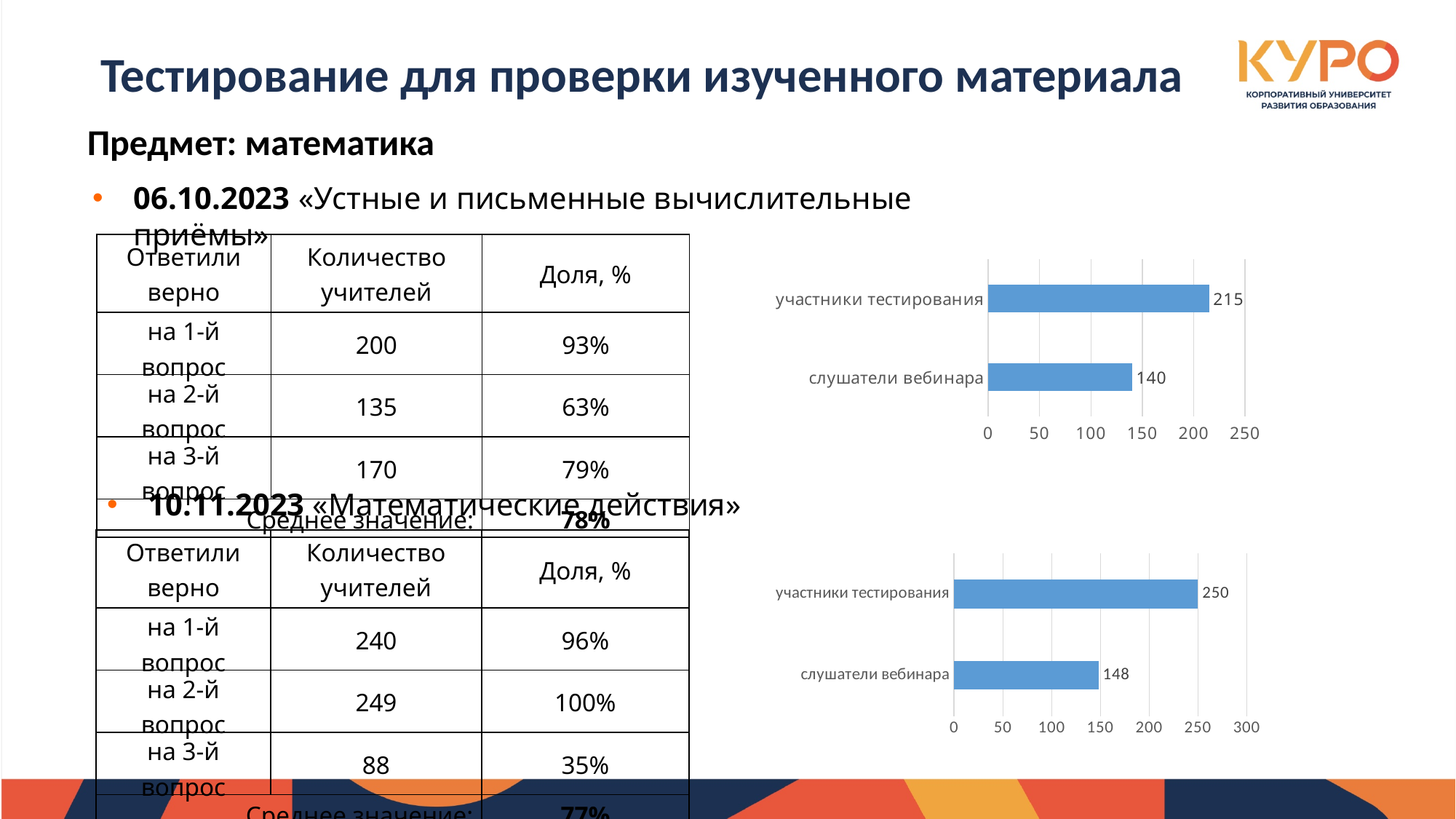
What is the maximum value shown on the x axis of the lower chart on the right? 300 In the upper chart on the right, what is the difference between участники тестирования and слушатели вебинара? 75 How many categories are shown in the upper chart on the right? 2 In the lower chart on the right, is the value for слушатели вебинара greater or less than 150? less In the upper chart on the right, which category has the higher value? участники тестирования What type of chart is the lower chart on the right? bar chart In the lower chart on the right, what is the value for участники тестирования? 250 In the upper chart on the right, what is the value for слушатели вебинара? 140 In the upper chart on the right, what is the value for участники тестирования? 215 In the lower chart on the right, which category has the lowest value? слушатели вебинара In the lower chart on the right, what is the value for слушатели вебинара? 148 In the lower chart on the right, what is the difference between участники тестирования and слушатели вебинара? 102